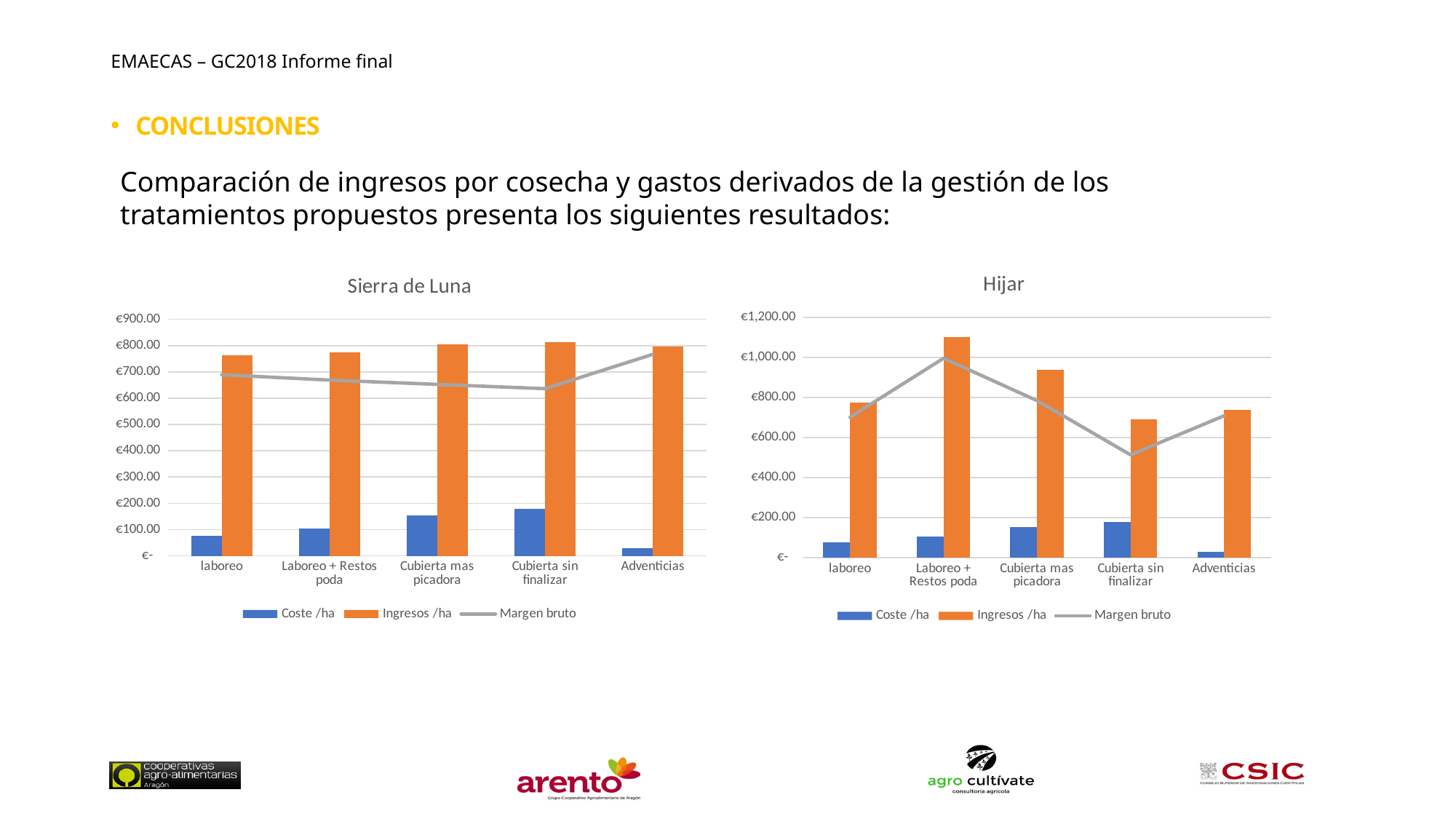
How many categories are shown on the x axis of the Sierra de Luna chart? 5 In the Hijar chart, which has the larger Ingresos /ha: Cubierta mas picadora or Cubierta sin finalizar? Cubierta mas picadora What kind of chart is the Sierra de Luna chart? bar chart with a line How many series does the legend of the Hijar chart list? 3 In the Sierra de Luna chart, is the Ingresos /ha value for laboreo greater or less than €800.00? less In the Hijar chart, is the Ingresos /ha value for Laboreo + Restos poda greater or less than €1,000.00? greater In the Hijar chart, which category has the highest Ingresos /ha? Laboreo + Restos poda In the Sierra de Luna chart, which category has the lowest Coste /ha? Adventicias In the Sierra de Luna chart, does Coste /ha rise or fall from laboreo to Cubierta sin finalizar? rises In the Hijar chart, which category has the lowest Margen bruto? Cubierta sin finalizar In the Hijar chart, what colour are the Ingresos /ha bars? orange In the Sierra de Luna chart, which category has the highest Coste /ha? Cubierta sin finalizar